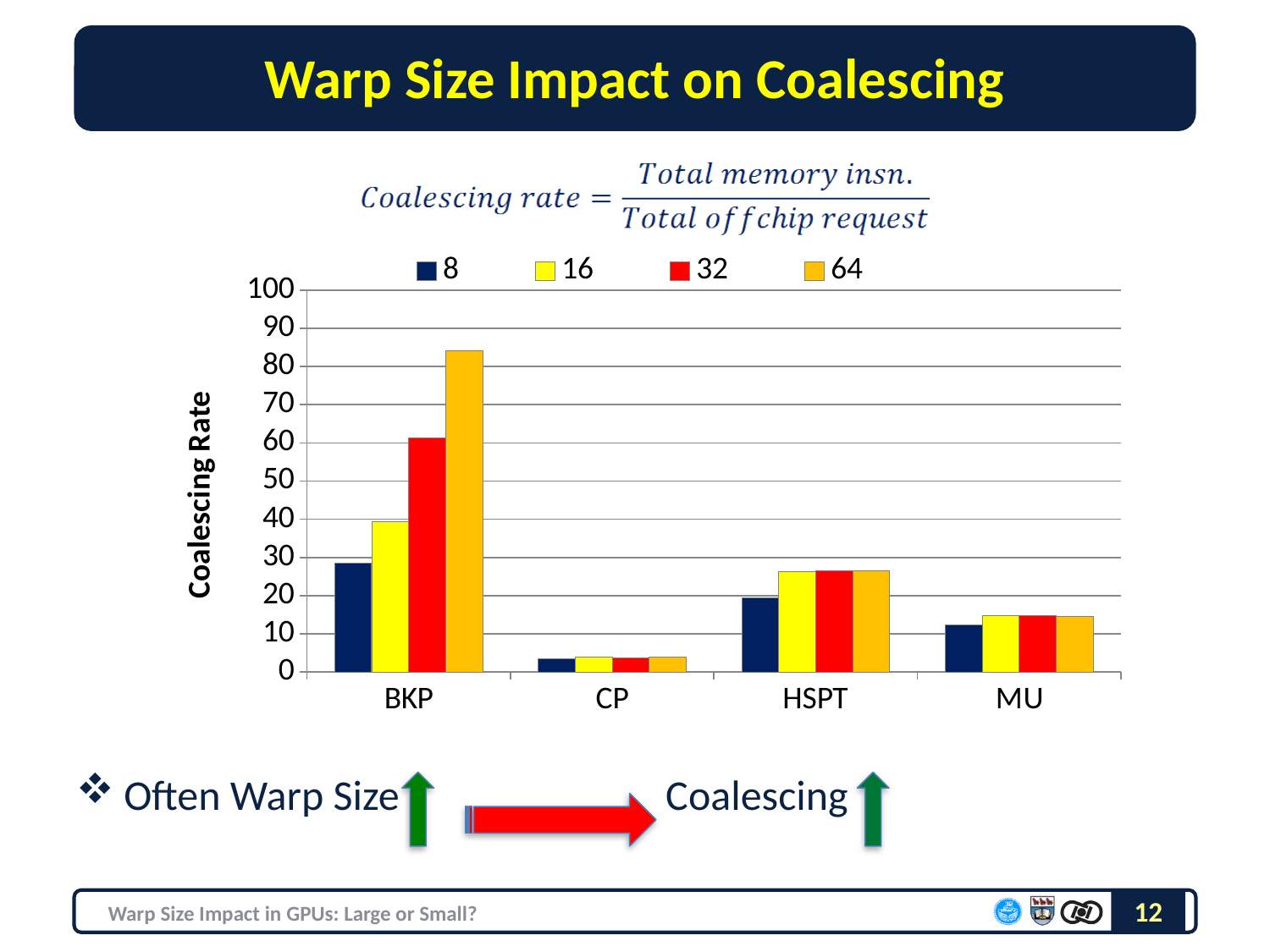
Is the coalescing rate for BKP with warp size 64 greater or less than 80? greater For BKP, which is larger: the coalescing rate for warp size 16 or for warp size 32? warp size 32 Which category has the lowest coalescing rate for warp size 8? CP What kind of chart is shown on the slide? bar chart For BKP, does the coalescing rate rise or fall as warp size increases from 8 to 64? rise How many categories are shown on the x axis? 4 Is the coalescing rate for MU with warp size 16 greater or less than 10? greater Is the coalescing rate for BKP with warp size 8 greater or less than 30? less How many series does the legend list? 4 What is the label of the y axis? Coalescing Rate Which category has the highest coalescing rate for warp size 64? BKP